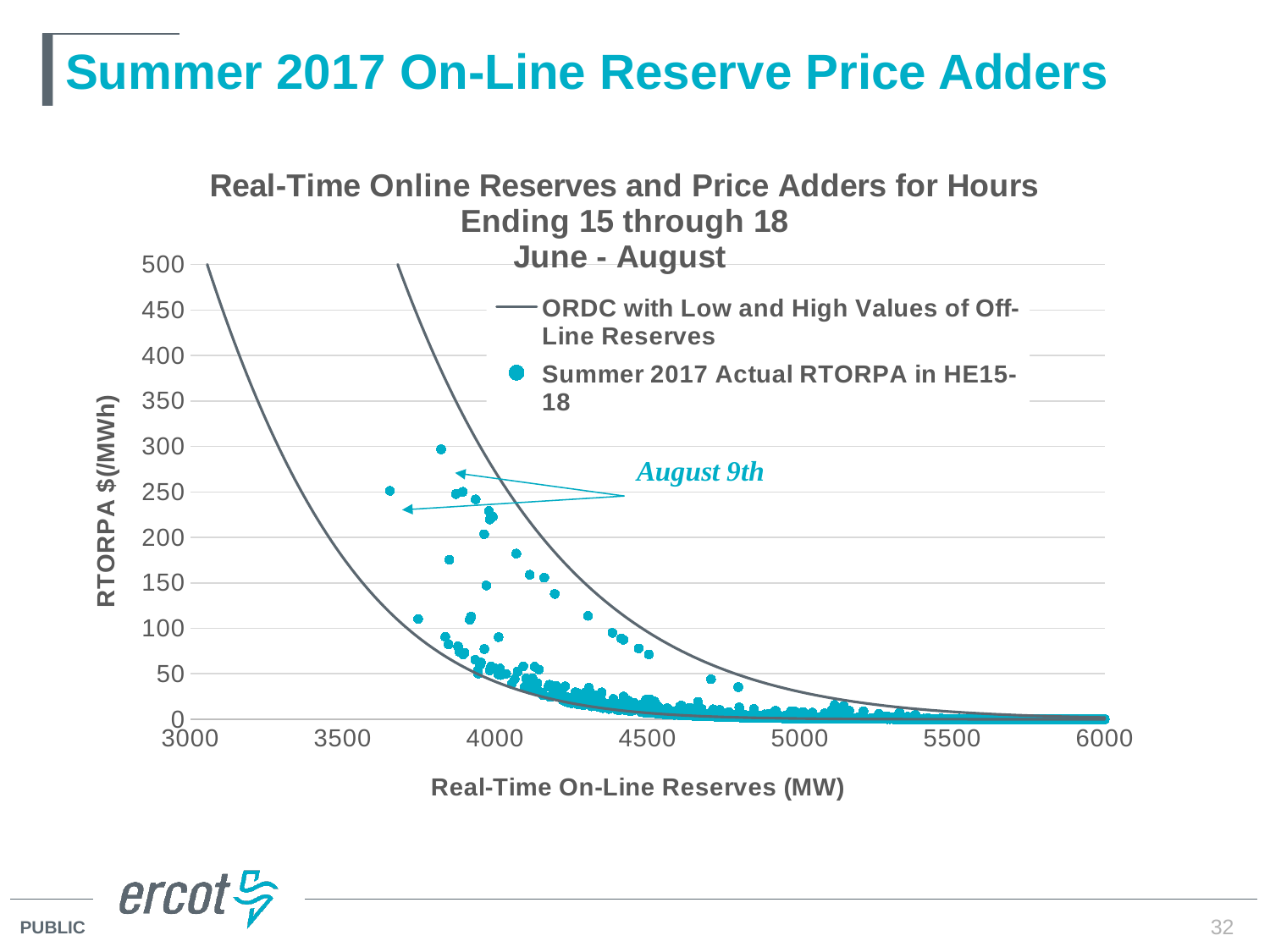
What is the title of the chart? Real-Time Online Reserves and Price Adders for Hours Ending 15 through 18 June - August Is the highest Summer 2017 Actual RTORPA data point greater or less than 250 $/MWh? greater What kind of chart is shown on the slide? Scatter chart How many series does the chart legend list? 2 What is the maximum value shown on the y axis? 500 What is the lowest value shown on the x axis? 3000 Are the Summer 2017 Actual RTORPA values at 5500 MW of reserves greater or less than 50 $/MWh? less As Real-Time On-Line Reserves increase along the x axis, do the RTORPA values rise or fall? Fall